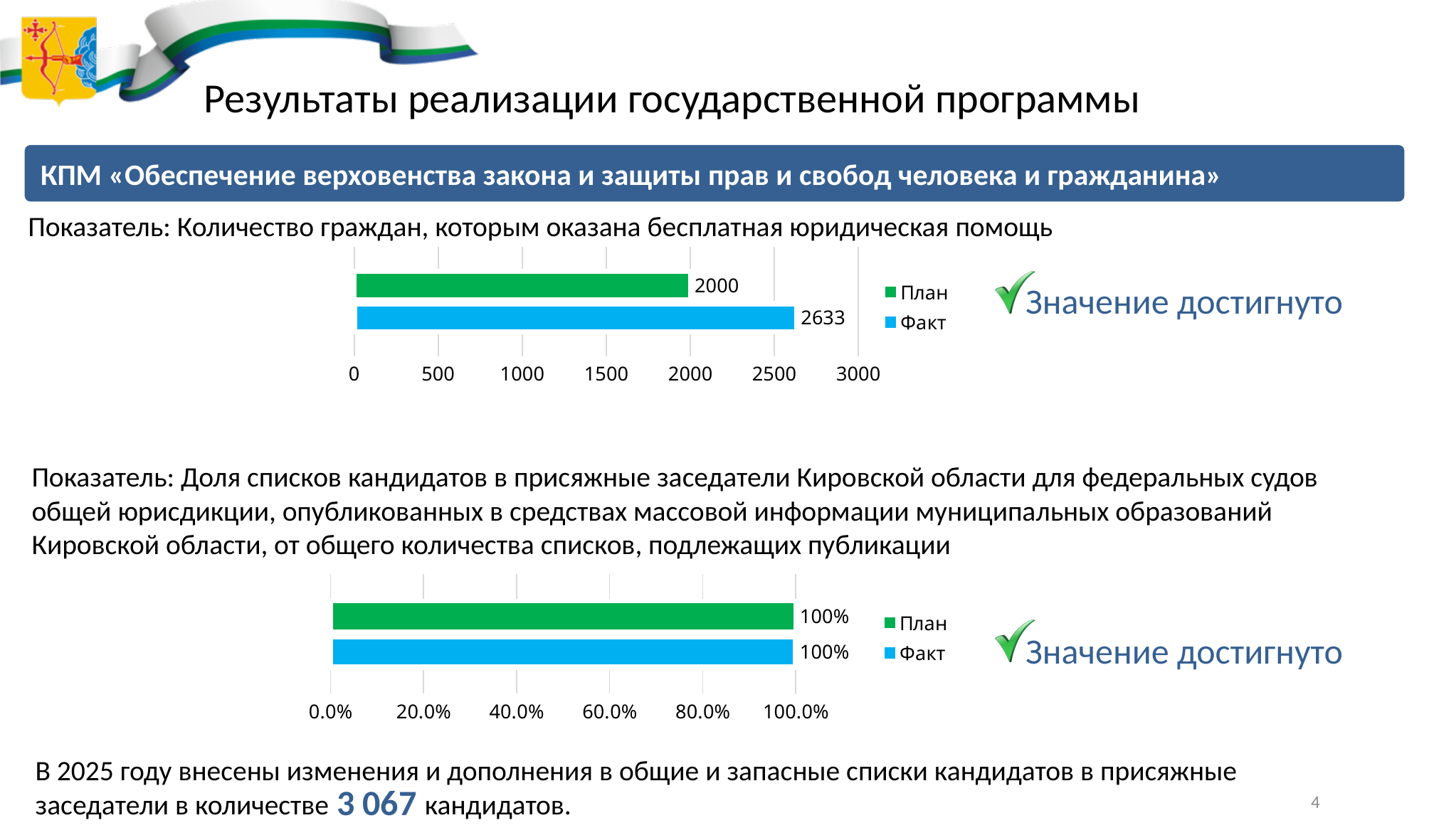
In the top chart, by how much does Факт exceed План? 633 What is the highest tick label on the x axis of the bottom chart? 100.0% In the top chart (number of citizens given free legal aid), what is the value for План? 2000 What kind of chart is the top chart? bar chart In the top chart, which series has the higher value, План or Факт? Факт In the bottom chart (share of jury candidate lists published), what is the value for Факт? 100% In the top chart (number of citizens given free legal aid), what is the value for Факт? 2633 In the top chart, what colour is the bar for Факт? blue In the bottom chart, what is the difference between План and Факт? 0% In the top chart, is the value for Факт greater or less than 2500? greater In the bottom chart (share of jury candidate lists published), what is the value for План? 100% How many series does the legend of the top chart list? 2